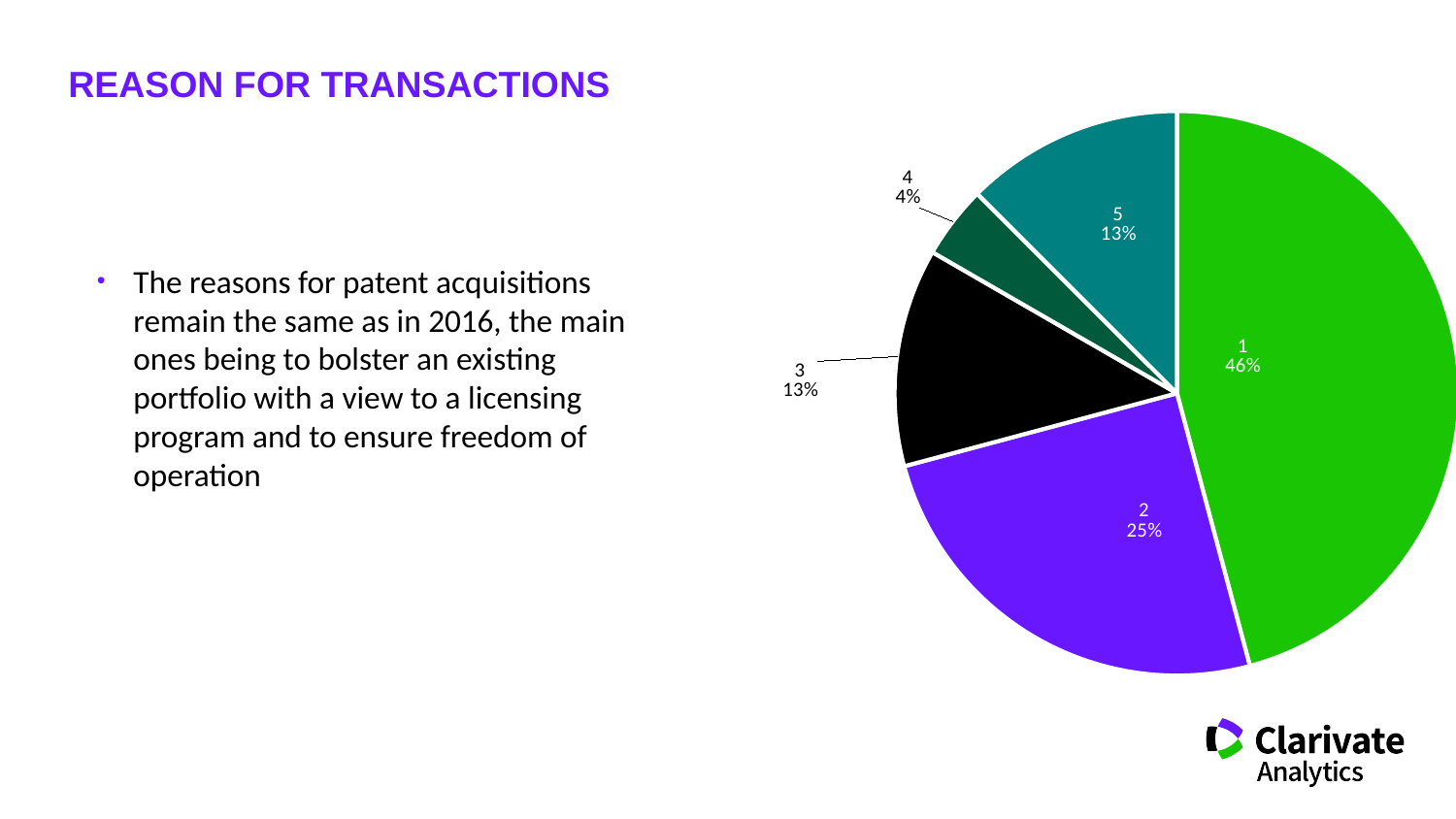
What percentage is shown for category 5? 13% What share of the pie does category 1 have? 46% What is the difference in percentage points between category 1 and category 2? 21 What percentage is shown for category 2 in the pie chart? 25% What is the title of the slide containing the pie chart? REASON FOR TRANSACTIONS What percentage is shown for category 4? 4% What kind of chart is shown on the slide? pie chart Which two categories have the same percentage in the pie chart? 3 and 5 Which category has the largest slice of the pie? 1 Which category has the smallest slice of the pie? 4 How many slices does the pie chart have? 5 Which is larger, the slice for category 2 or the slice for category 3? 2